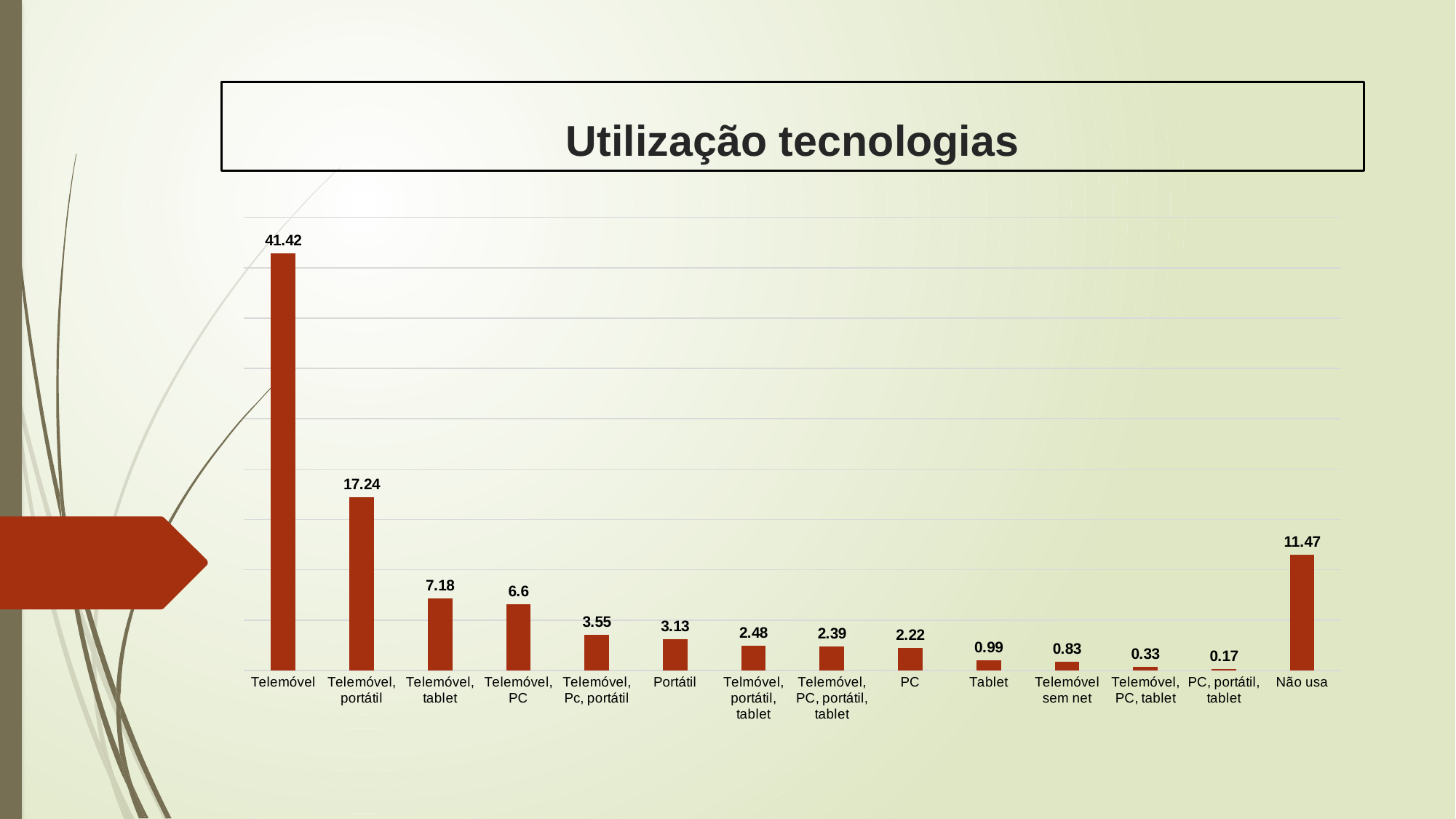
What is the value for Tablet? 0.99 What is the difference between the values for Telemóvel and Telemóvel, portátil? 24.18 Which category has the lowest value? PC, portátil, tablet What is the difference between the values for Não usa and Telemóvel, tablet? 4.29 What kind of chart is shown on the slide? Bar chart Which category has the highest value? Telemóvel What is the value for Telemóvel, PC? 6.6 How many categories are shown on the x axis? 14 What is the value for Telemóvel? 41.42 What is the title of the chart? Utilização tecnologias What is the value for Não usa? 11.47 Which is larger, the value for Portátil or the value for PC? Portátil